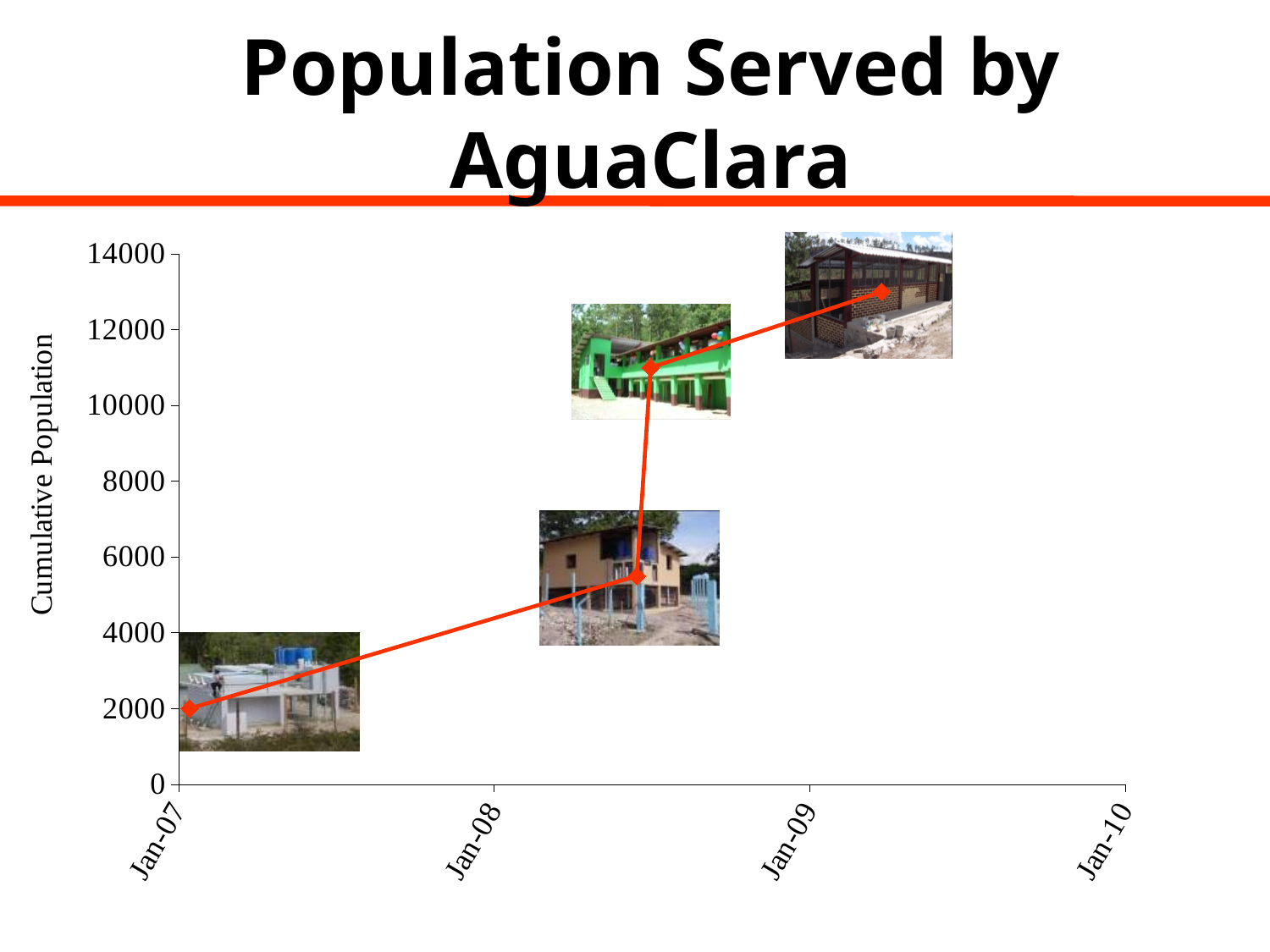
Is the value of the last data point greater or less than 12000? greater What is the label on the vertical axis? Cumulative Population Is the value of the second data point greater or less than 6000? less What kind of chart is shown on the slide? line chart Do the values rise or fall from Jan-07 toward Jan-10? rise How many data points are plotted on the line? 4 Is the value of the third data point greater or less than 10000? greater What is the highest value shown on the vertical axis? 14000 What is the title of the chart? Population Served by AguaClara Which data point has the highest cumulative population, the first or the last? the last